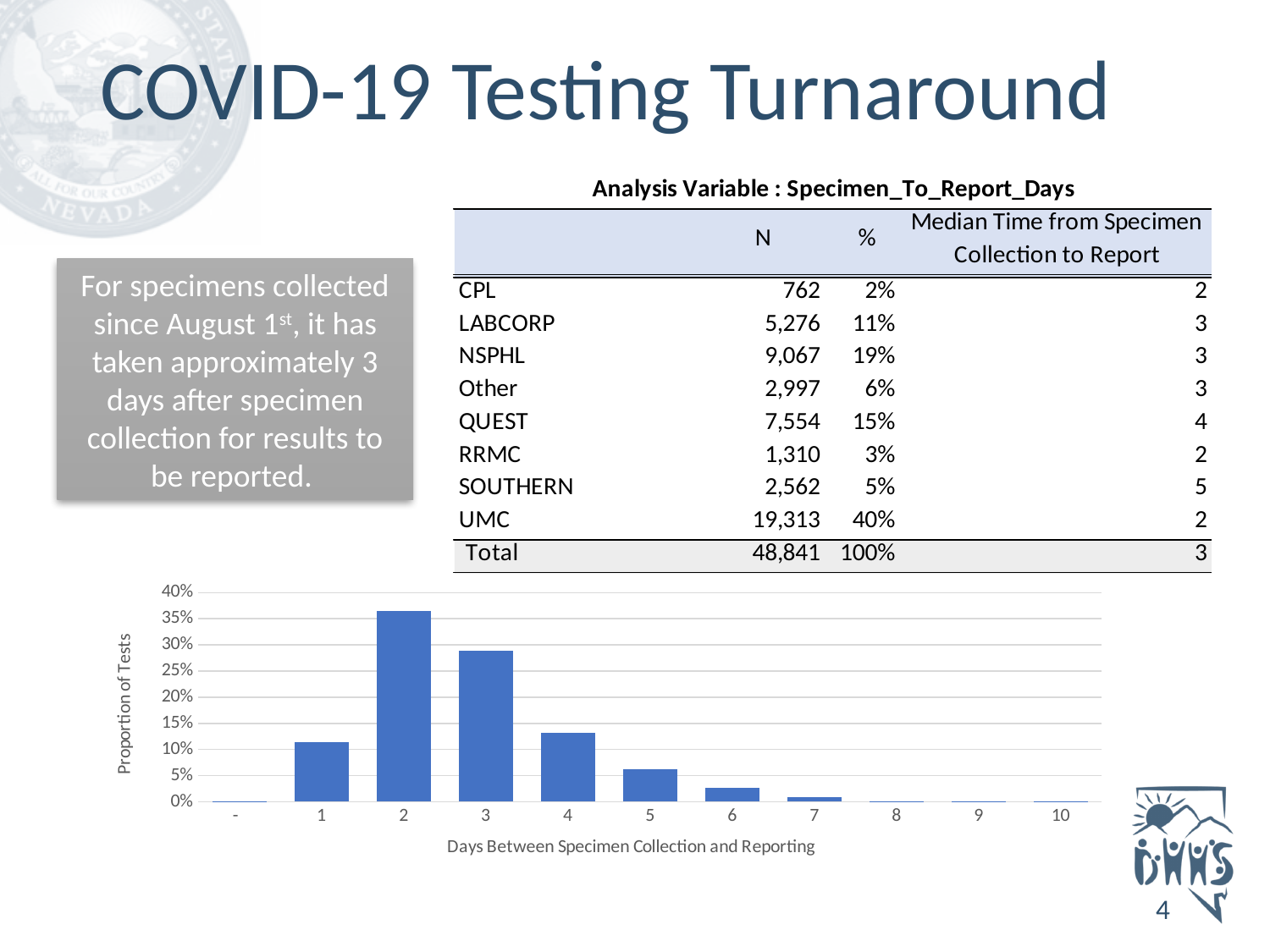
Is the proportion of tests for 5 days greater or less than 10%? less Which number of days between specimen collection and reporting has the highest proportion of tests? 2 Is the proportion of tests for 2 days greater or less than 35%? greater How many categories are shown along the x axis of the bar chart? 11 Is the proportion of tests for 1 day greater or less than 10%? greater What kind of chart is shown on the slide? bar chart Do the proportions of tests rise or fall as the number of days increases from 2 to 7? fall What is the label of the y axis of the bar chart? Proportion of Tests What is the label of the x axis of the bar chart? Days Between Specimen Collection and Reporting Which has a larger proportion of tests, 3 days or 4 days? 3 days